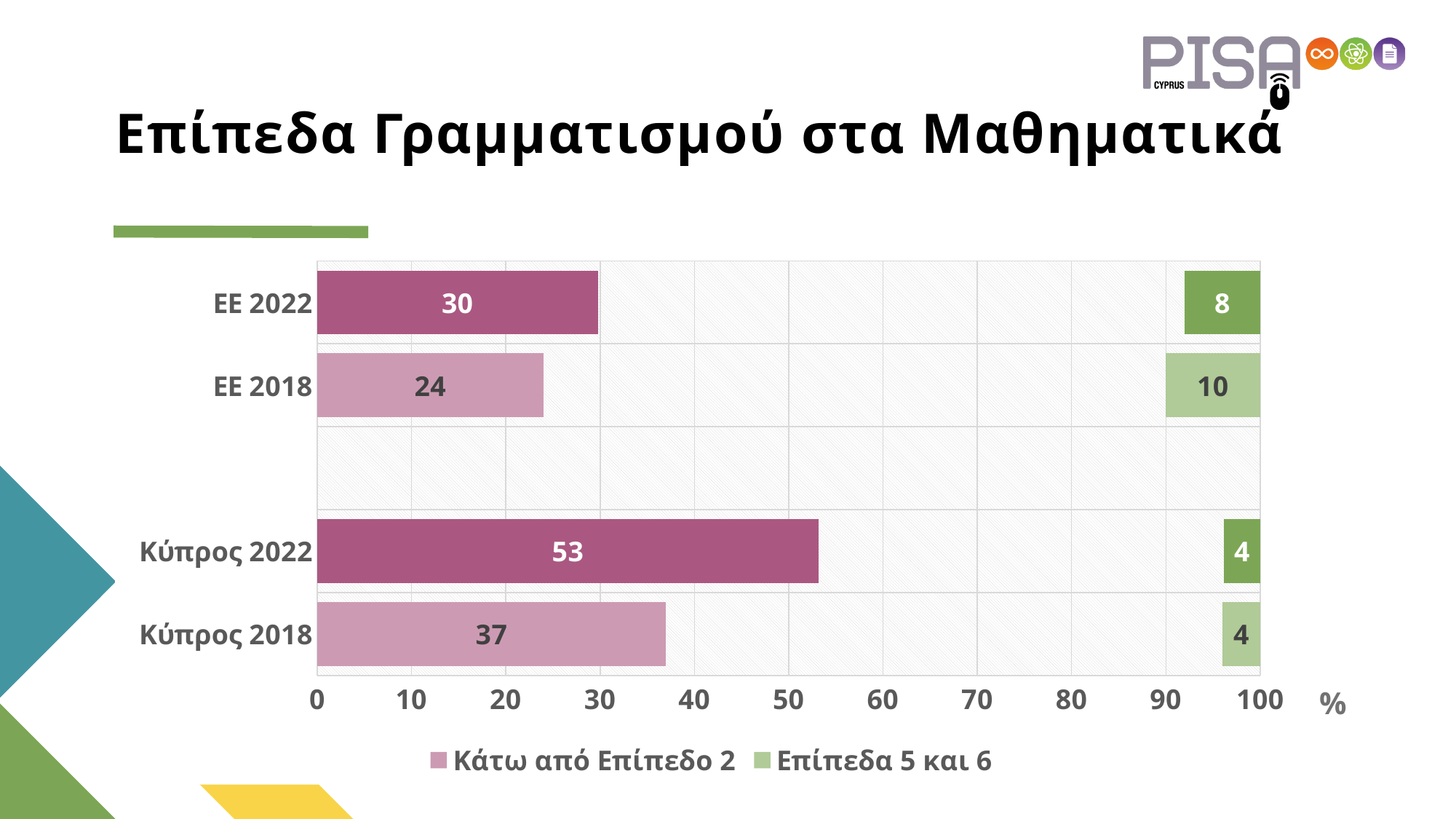
What is the value for Κύπρος 2018 in the Επίπεδα 5 και 6 series? 4 Which is larger in the Κάτω από Επίπεδο 2 series: EE 2022 or EE 2018? EE 2022 What is the value for EE 2018 in the Επίπεδα 5 και 6 series? 10 How many categories are shown on the chart? 4 Which category has the lowest value in the Κάτω από Επίπεδο 2 series? EE 2018 What kind of chart is shown on the slide? Bar chart What is the value for Κύπρος 2022 in the Κάτω από Επίπεδο 2 series? 53 What is the difference between the Κάτω από Επίπεδο 2 values for Κύπρος 2022 and Κύπρος 2018? 16 What is the value for EE 2022 in the Κάτω από Επίπεδο 2 series? 30 Which category has the highest value in the Κάτω από Επίπεδο 2 series? Κύπρος 2022 Which category has the highest value in the Επίπεδα 5 και 6 series? EE 2018 How many series does the legend list? 2